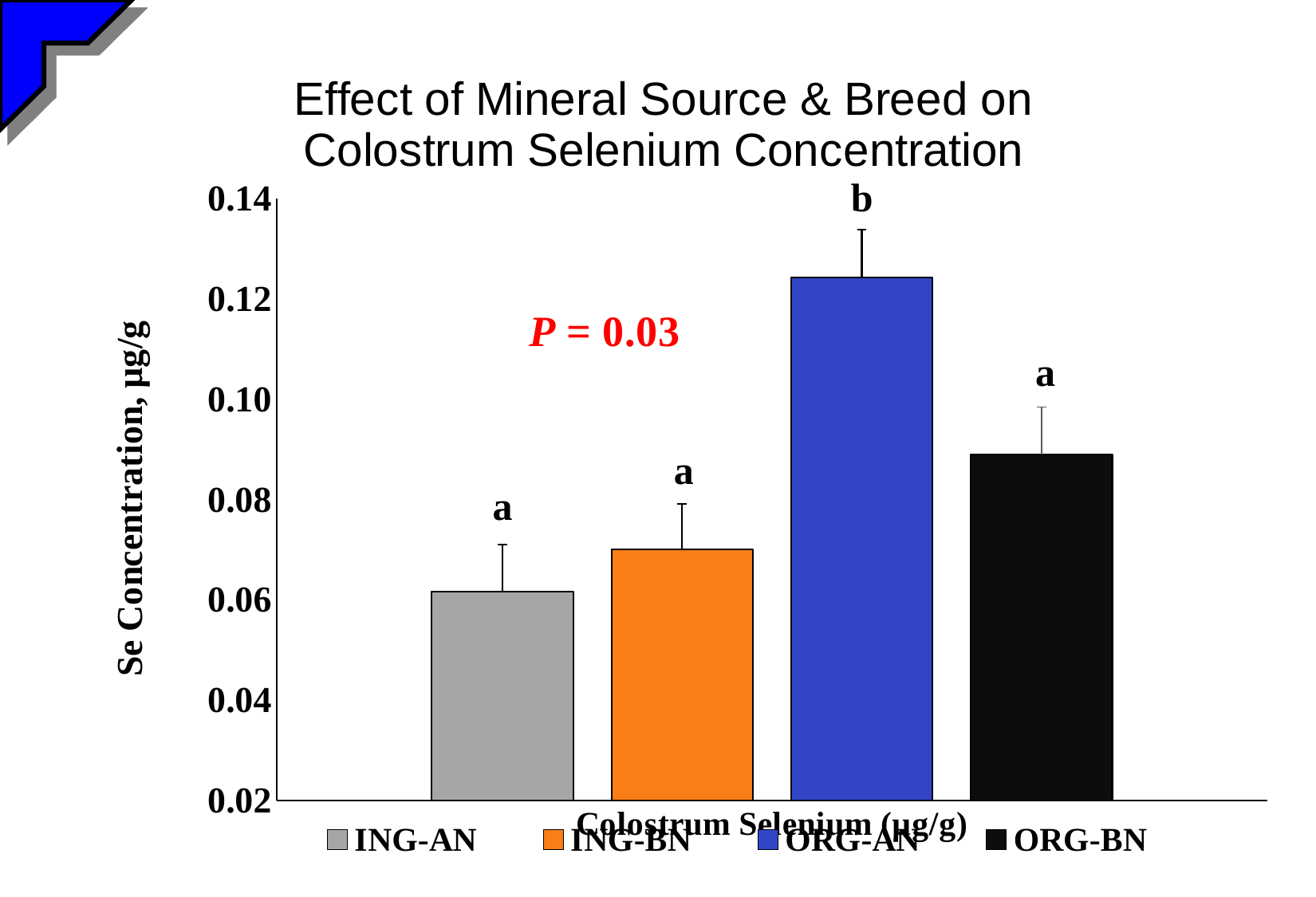
Is the value for ORG-BN greater or less than 0.08? greater Which is larger, the value for ORG-BN or the value for ING-BN? ORG-BN Is the value for ING-AN greater or less than 0.08? less Is the value for ORG-BN greater or less than 0.10? less What is the label of the y axis? Se Concentration, µg/g Which group has the lowest colostrum selenium concentration? ING-AN What P value is printed on the chart? P = 0.03 What kind of chart is shown on the slide? bar chart Which group has the highest colostrum selenium concentration? ORG-AN How many series does the legend list? 4 How many bars are plotted in the chart? 4